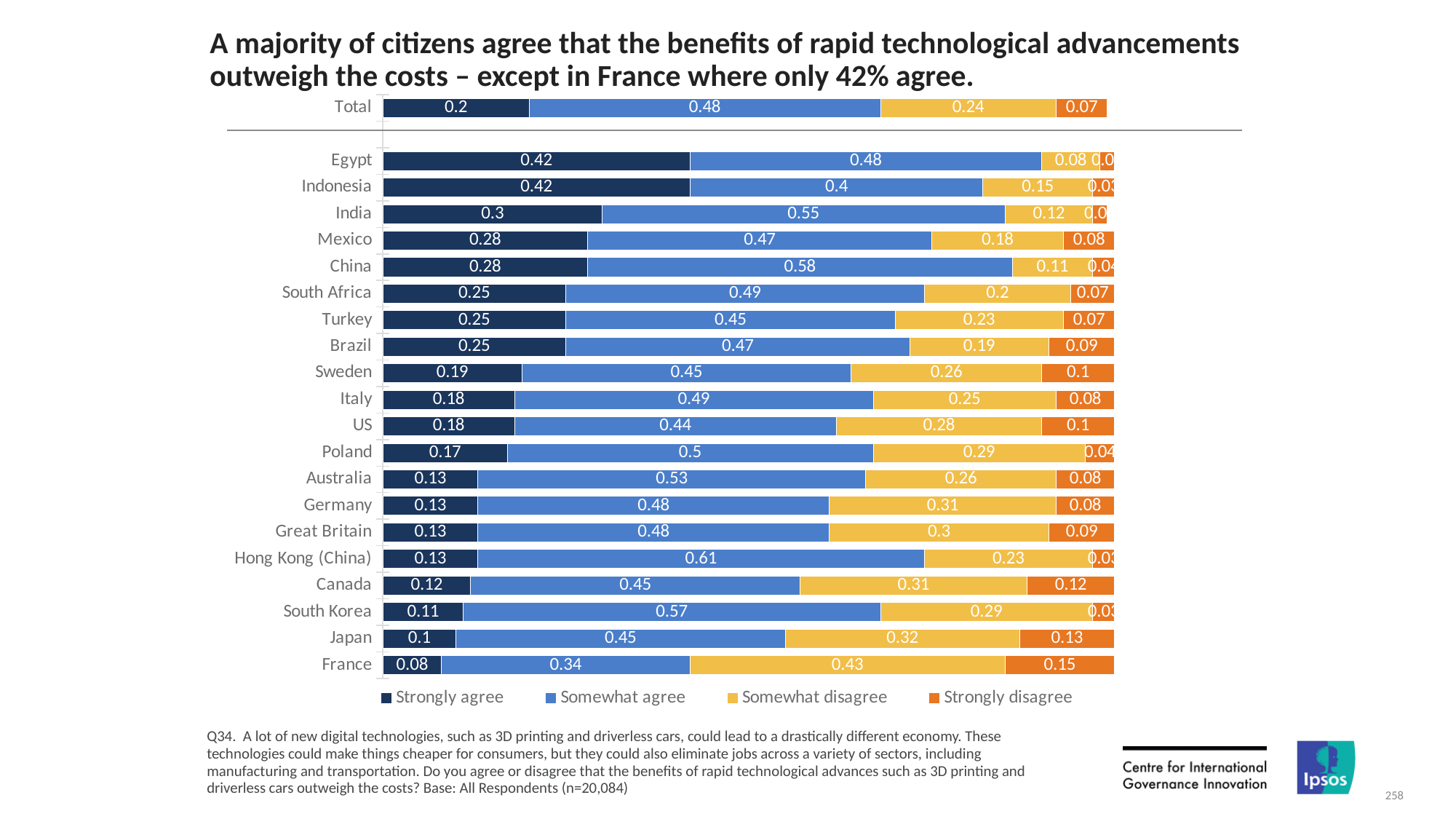
What is the Somewhat disagree value for Total? 0.24 What is the Strongly agree value for France? 0.08 Which country has the highest Somewhat agree value? Hong Kong (China) What is the Somewhat agree value for Hong Kong (China)? 0.61 How many series does the legend list? 4 Which country has the lowest Strongly agree value? France Which country has the highest Strongly disagree value? France How many countries are shown in the chart, excluding Total? 20 Which has a larger Strongly agree value, India or Mexico? India What is the difference between the Somewhat disagree values for France and Germany? 0.12 What kind of chart is shown on the slide? Stacked bar chart What is the Strongly disagree value for Japan? 0.13